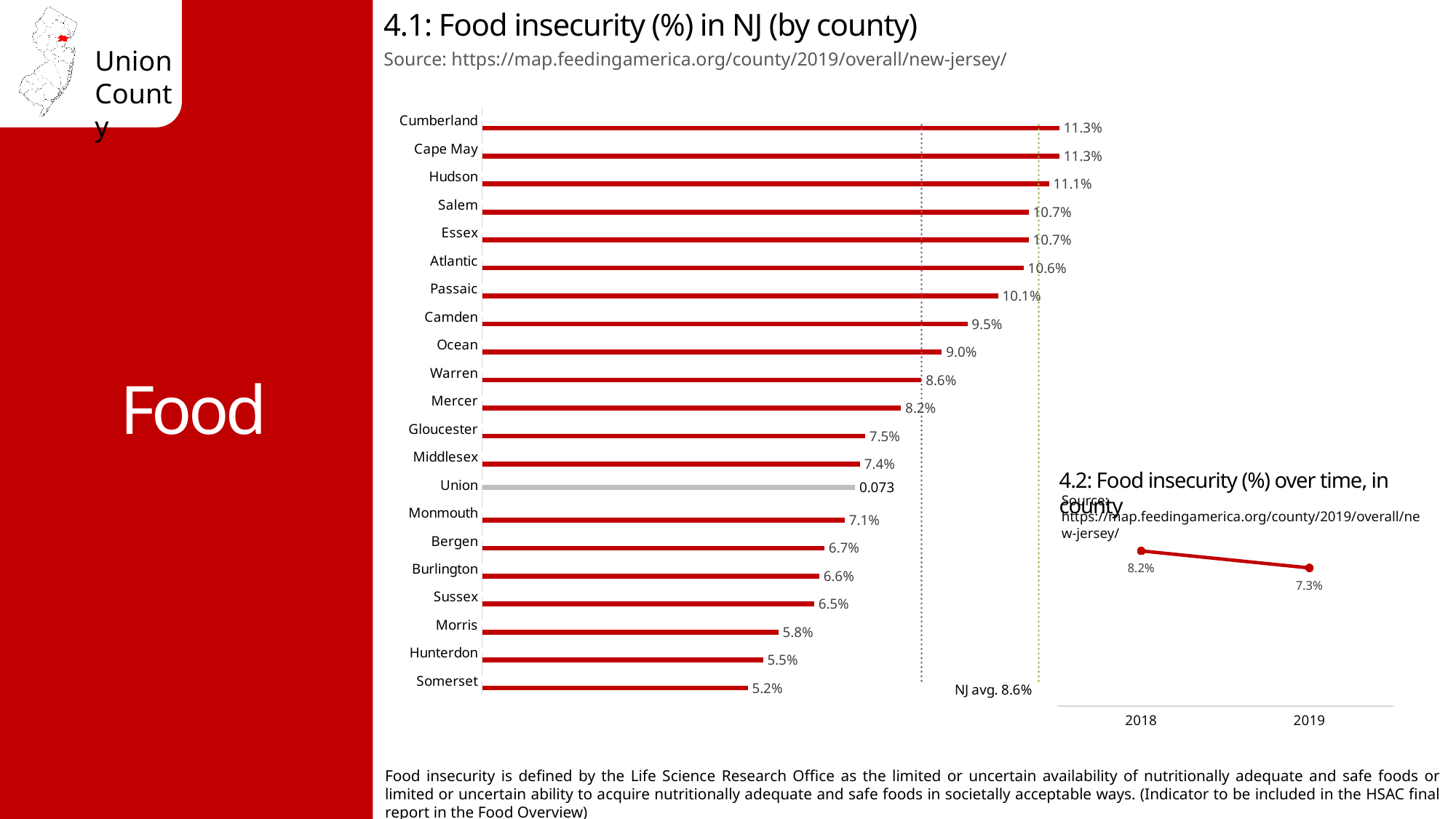
What kind of chart is chart 4.1 (Food insecurity by county)? bar chart In chart 4.1 (Food insecurity by county), how many counties are plotted? 21 In chart 4.1 (Food insecurity by county), what label is printed next to the Union bar? 0.073 In chart 4.1 (Food insecurity by county), what is the difference between Passaic and Camden? 0.6% In chart 4.2 (Food insecurity over time), what is the difference between the 2018 and 2019 values? 0.9% In chart 4.1 (Food insecurity by county), which county has the lowest value? Somerset In chart 4.1 (Food insecurity by county), which is larger, Bergen or Sussex? Bergen In chart 4.2 (Food insecurity over time), does the value rise or fall from 2018 to 2019? fall In chart 4.1 (Food insecurity by county), what is the value for Hudson? 11.1% In chart 4.2 (Food insecurity over time), what is the value for 2019? 7.3% In chart 4.1 (Food insecurity by county), what NJ average value is labelled on the chart? 8.6% In chart 4.1 (Food insecurity by county), what is the value for Somerset? 5.2%